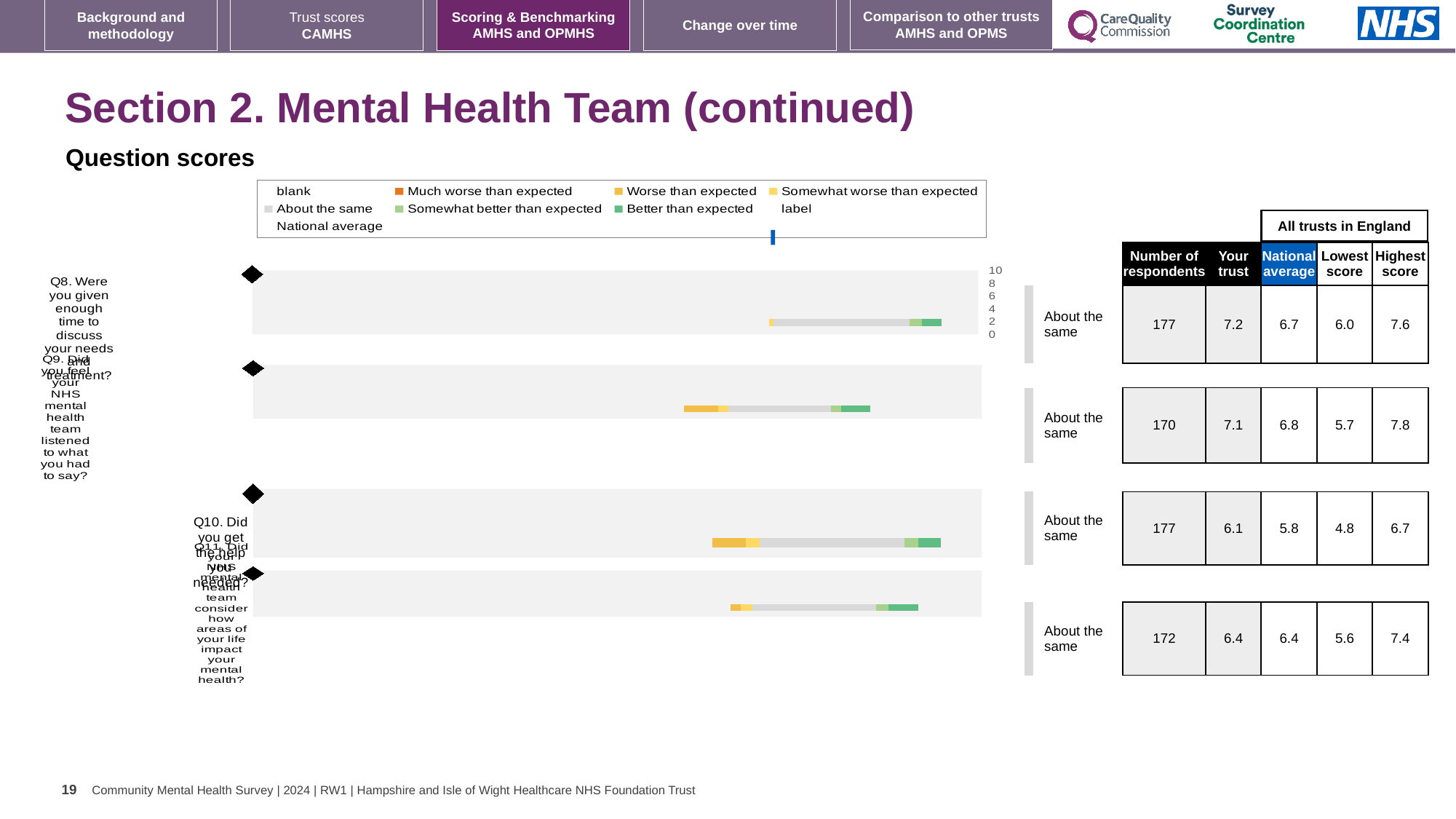
For Q9, which is larger in the table beside the chart: the 'Your trust' score or the national average? Your trust In the chart legend, what colour represents 'Much worse than expected'? orange How many survey questions (bars) are plotted in the question scores chart? 4 In the table beside the chart, what is the highest score across all trusts in England for Q9? 7.8 In the chart legend, what colour represents 'Better than expected'? green In the table beside the chart, what is the national average for Q11 (Did your NHS mental health team consider how areas of your life impact your mental health)? 6.4 For Q8, how much higher is the 'Your trust' score than the national average in the table beside the chart? 0.5 In the table beside the chart, what is the number of respondents for Q9 (Did you feel your NHS mental health team listened to what you had to say)? 170 Which question has the highest 'Your trust' score in the table beside the chart? Q8 Which question has the lowest 'Your trust' score in the table beside the chart? Q10 What type of chart is used to show the question scores on this slide? bar chart In the table beside the chart, what is the 'Your trust' score for Q8 (Were you given enough time to discuss your needs and treatment)? 7.2